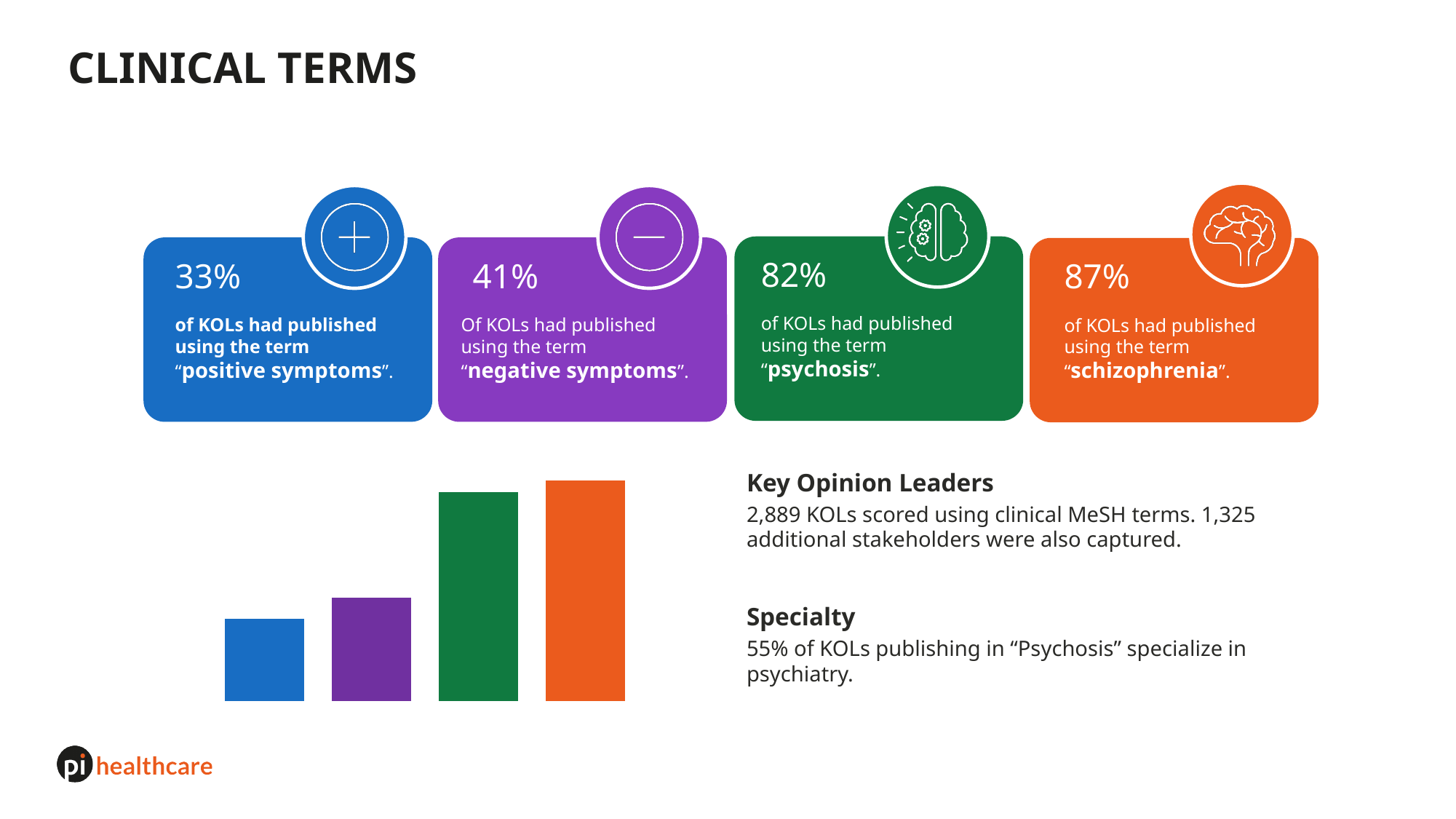
How many bars does the bar chart contain? 4 What is the difference in percentage points between the "schizophrenia" and "psychosis" values? 5 Which is larger: the percentage for "negative symptoms" or for "positive symptoms"? negative symptoms What is the difference in percentage points between the "negative symptoms" and "positive symptoms" values? 8 Which clinical term has the highest percentage of KOLs publishing with it? schizophrenia What percentage of KOLs had published using the term "negative symptoms"? 41% Which clinical term has the lowest percentage of KOLs publishing with it? positive symptoms What percentage of KOLs had published using the term "psychosis"? 82% What kind of chart is shown at the bottom left of the slide? bar chart What percentage of KOLs had published using the term "schizophrenia"? 87% Do the bars in the bar chart rise or fall from left to right? rise What percentage of KOLs had published using the term "positive symptoms"? 33%